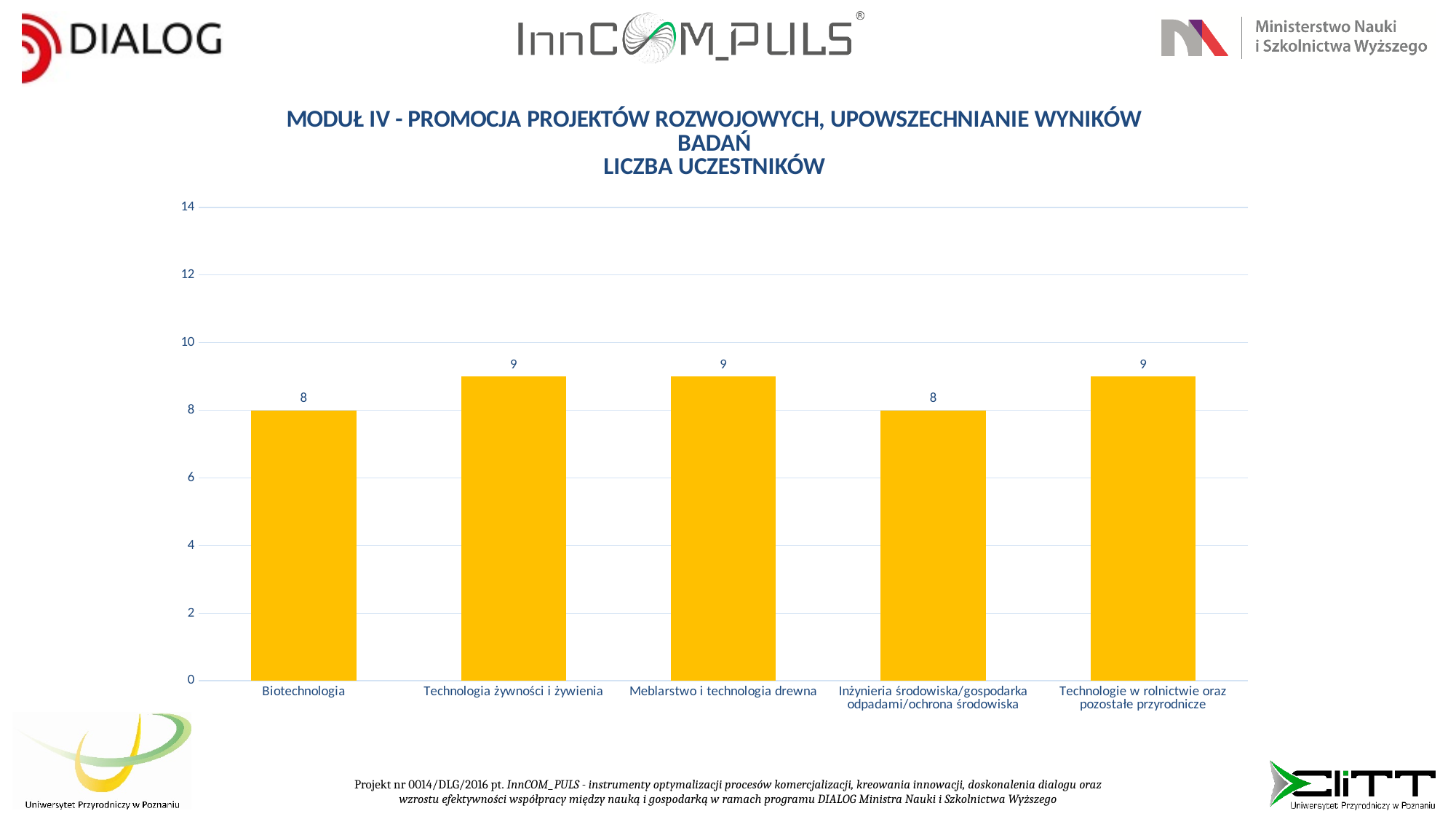
What colour are the bars in the chart? yellow What is the value for Technologia żywności i żywienia? 9 What is the value for Technologie w rolnictwie oraz pozostałe przyrodnicze? 9 What is the value for Biotechnologia? 8 What is the highest value shown on the y axis? 14 What is the value for Inżynieria środowiska/gospodarka odpadami/ochrona środowiska? 8 What kind of chart is shown on the slide? bar chart What is the value for Meblarstwo i technologia drewna? 9 Which is larger, the value for Meblarstwo i technologia drewna or the value for Inżynieria środowiska/gospodarka odpadami/ochrona środowiska? Meblarstwo i technologia drewna Is the value for Biotechnologia greater or less than 10? less What is the difference between the values for Technologia żywności i żywienia and Biotechnologia? 1 How many categories are shown on the chart? 5